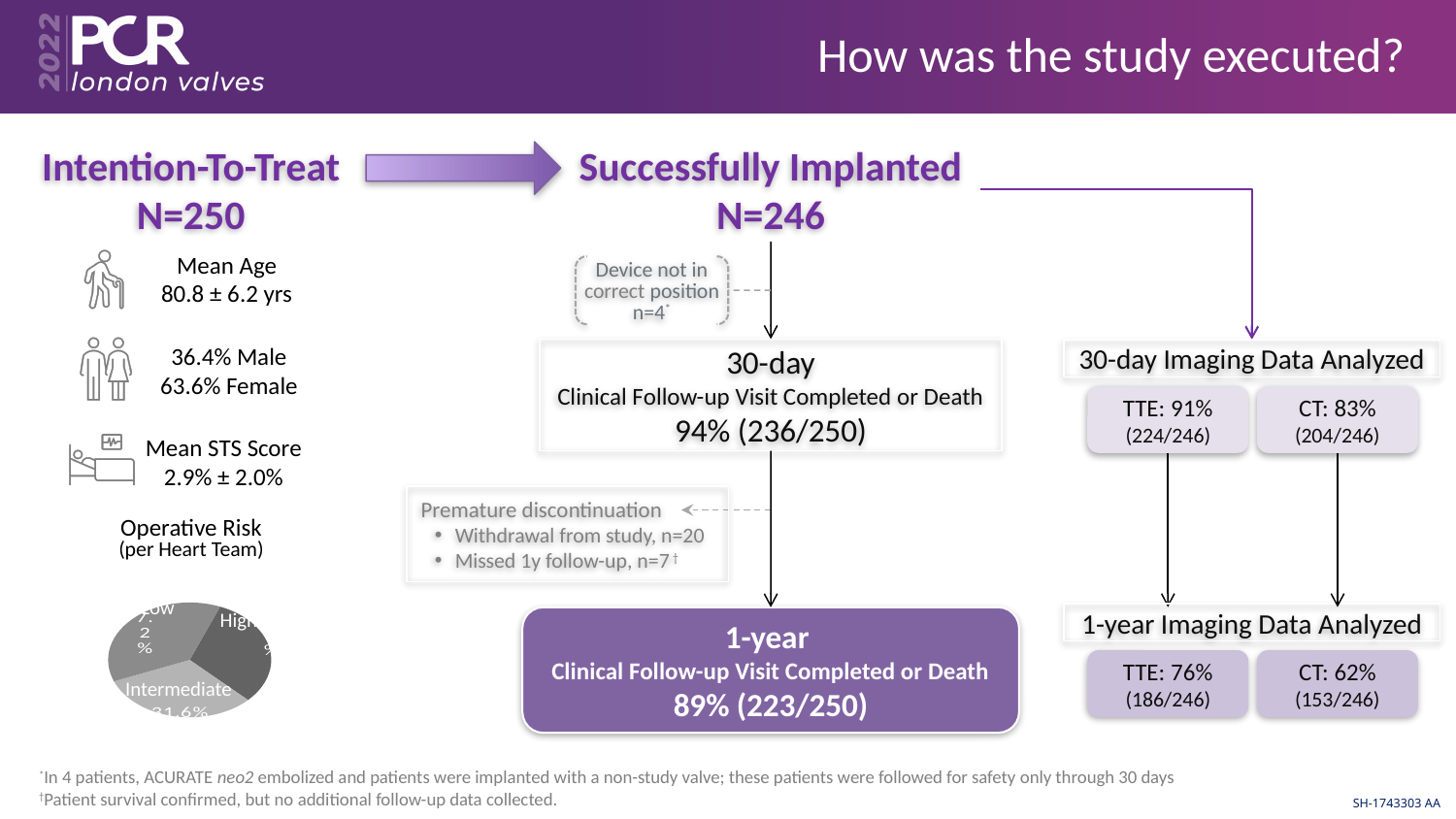
What kind of chart is shown under "Operative Risk (per Heart Team)"? pie chart What is the title of the pie chart on the slide? Operative Risk (per Heart Team) Which category has the largest slice in the Operative Risk pie chart? Low Which three risk categories are labelled in the Operative Risk pie chart? Low, High, Intermediate In the Operative Risk pie chart, which slice is larger: Intermediate or Low? Low How many slices does the Operative Risk pie chart have? 3